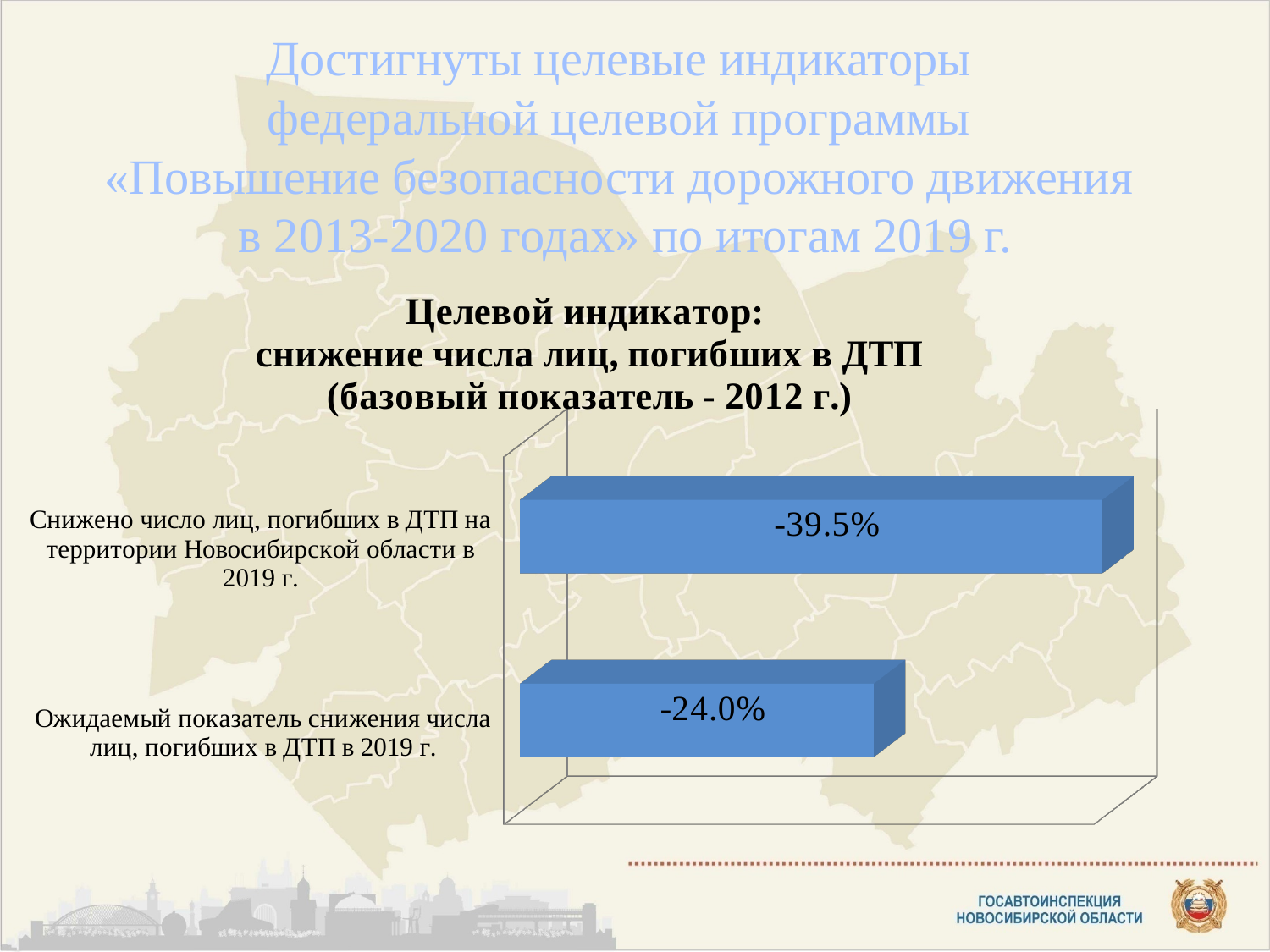
By how many percentage points does the actual reduction (-39.5%) exceed the expected reduction (-24.0%)? 15.5 percentage points Which bar is longer: the actual reduction in 2019 ("Снижено число лиц...") or the expected reduction ("Ожидаемый показатель...")? Снижено число лиц, погибших в ДТП на территории Новосибирской области в 2019 г. What is the base year stated in the chart heading for the target indicator? 2012 г. What value is shown for the bar labelled "Ожидаемый показатель снижения числа лиц, погибших в ДТП в 2019 г."? -24.0% Which category has the numerically highest value on the chart? Ожидаемый показатель снижения числа лиц, погибших в ДТП в 2019 г. What colour are the bars in the chart? Blue What kind of chart is shown on the slide? Bar chart How many bars (categories) does the chart show? 2 What value is shown for the bar labelled "Снижено число лиц, погибших в ДТП на территории Новосибирской области в 2019 г."? -39.5% Which category has the numerically lowest value on the chart? Снижено число лиц, погибших в ДТП на территории Новосибирской области в 2019 г.